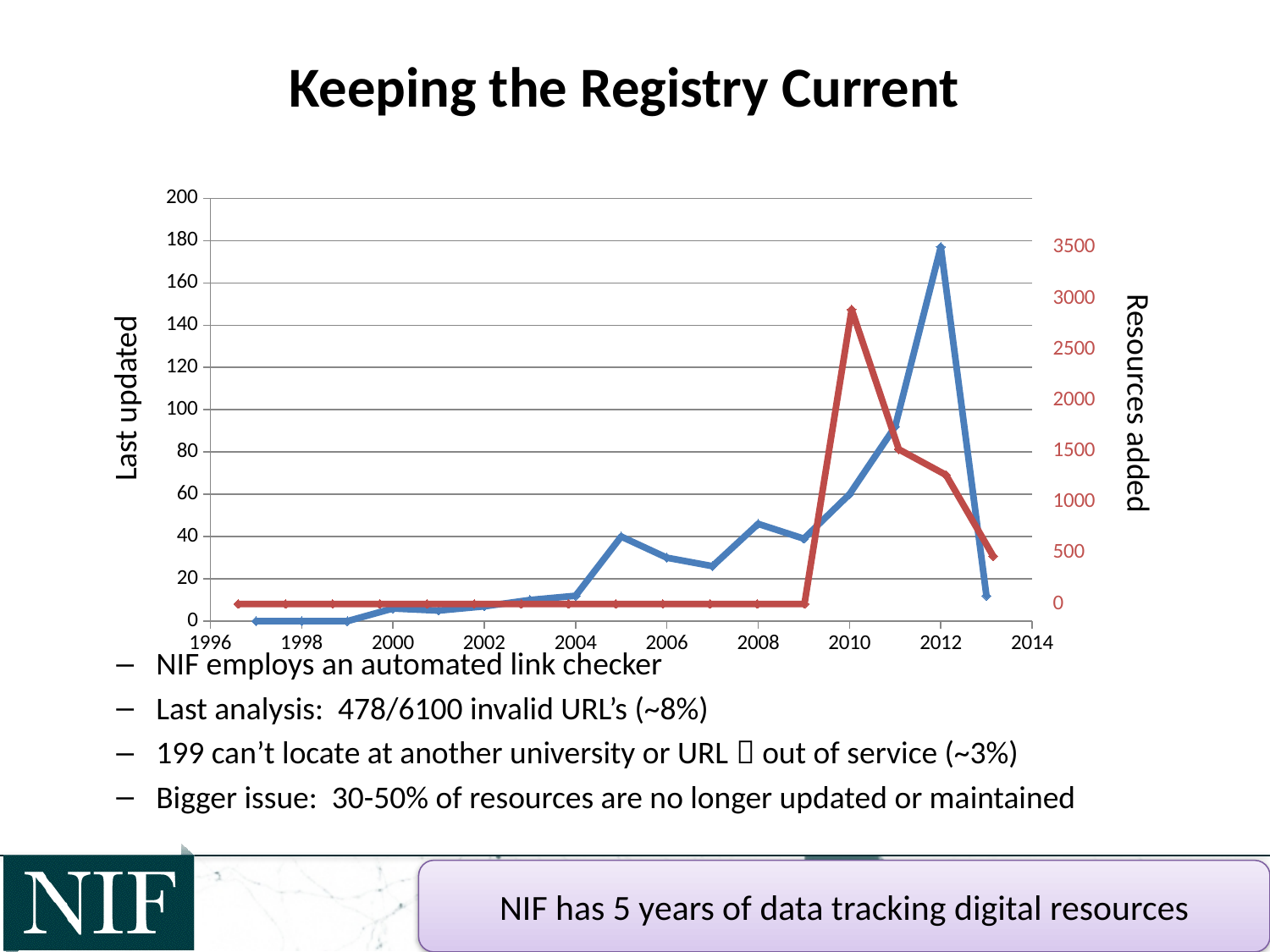
Does the Last updated line rise or fall from 2010 to 2012? rise Is the Resources added value for 2012 greater or less than 1500? less Is the Resources added value for 2010 greater or less than 2500? greater In which year does the Last updated line reach its highest value? 2012 Is the Last updated value for 2005 greater or less than 20? greater What is the label of the right-hand vertical axis of the chart? Resources added In which year does the Resources added line reach its highest value? 2010 Does the Resources added line rise or fall from 2010 to 2013? fall What kind of chart is shown on the slide? line chart Which year has the larger Last updated value, 2005 or 2006? 2005 What is the title of the slide containing the chart? Keeping the Registry Current